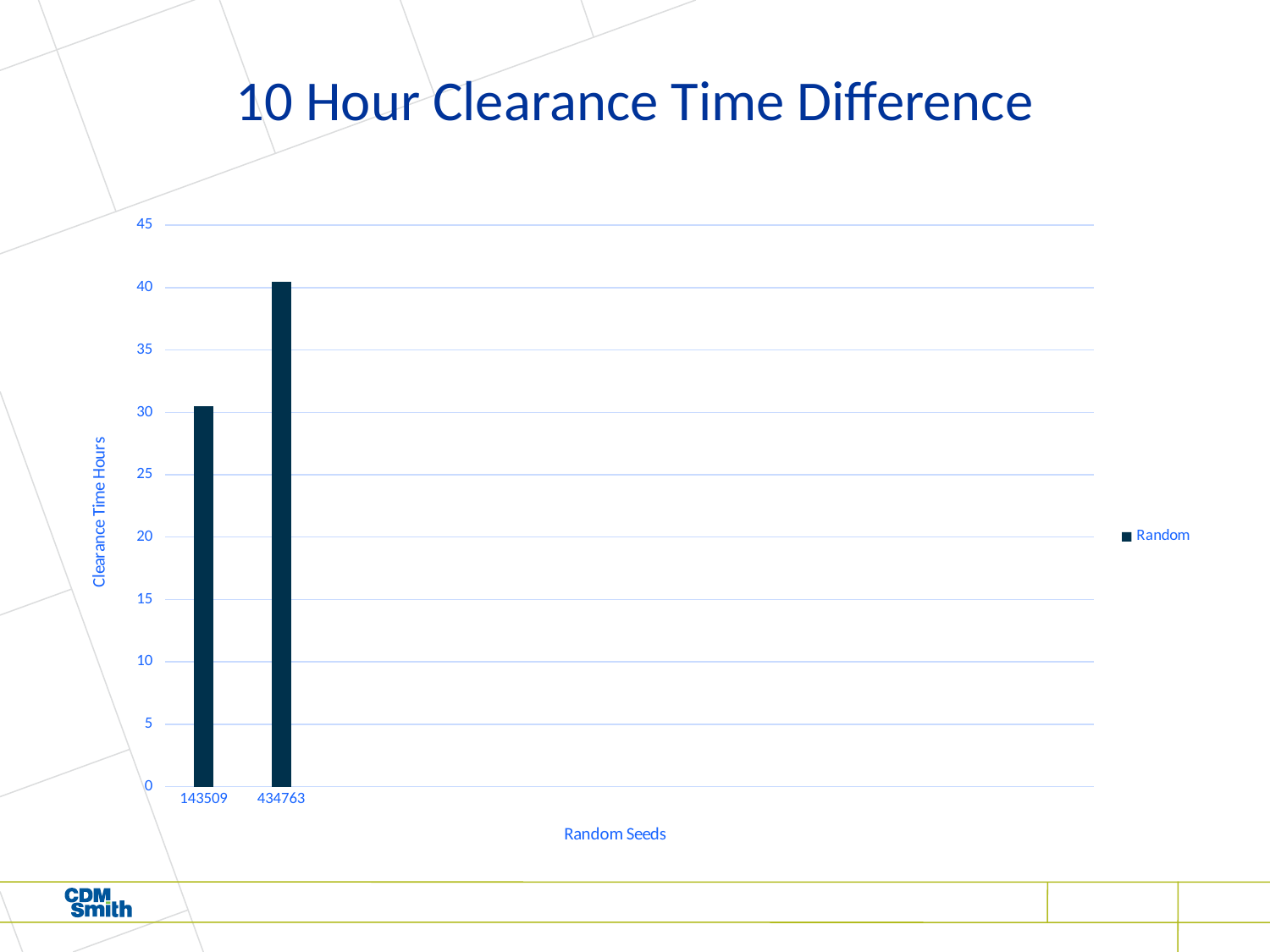
Which has a larger clearance time, seed 143509 or seed 434763? 434763 How many series does the legend list? 1 What series name is shown in the legend? Random Which random seed has the lowest clearance time? 143509 What kind of chart is shown on the slide? bar chart Is the value for seed 434763 greater or less than 45? less Is the value for seed 143509 greater or less than 35? less What is the title of the chart? 10 Hour Clearance Time Difference Which random seed has the highest clearance time? 434763 Is the value for seed 143509 greater or less than 25? greater How many bars (categories) are plotted in the chart? 2